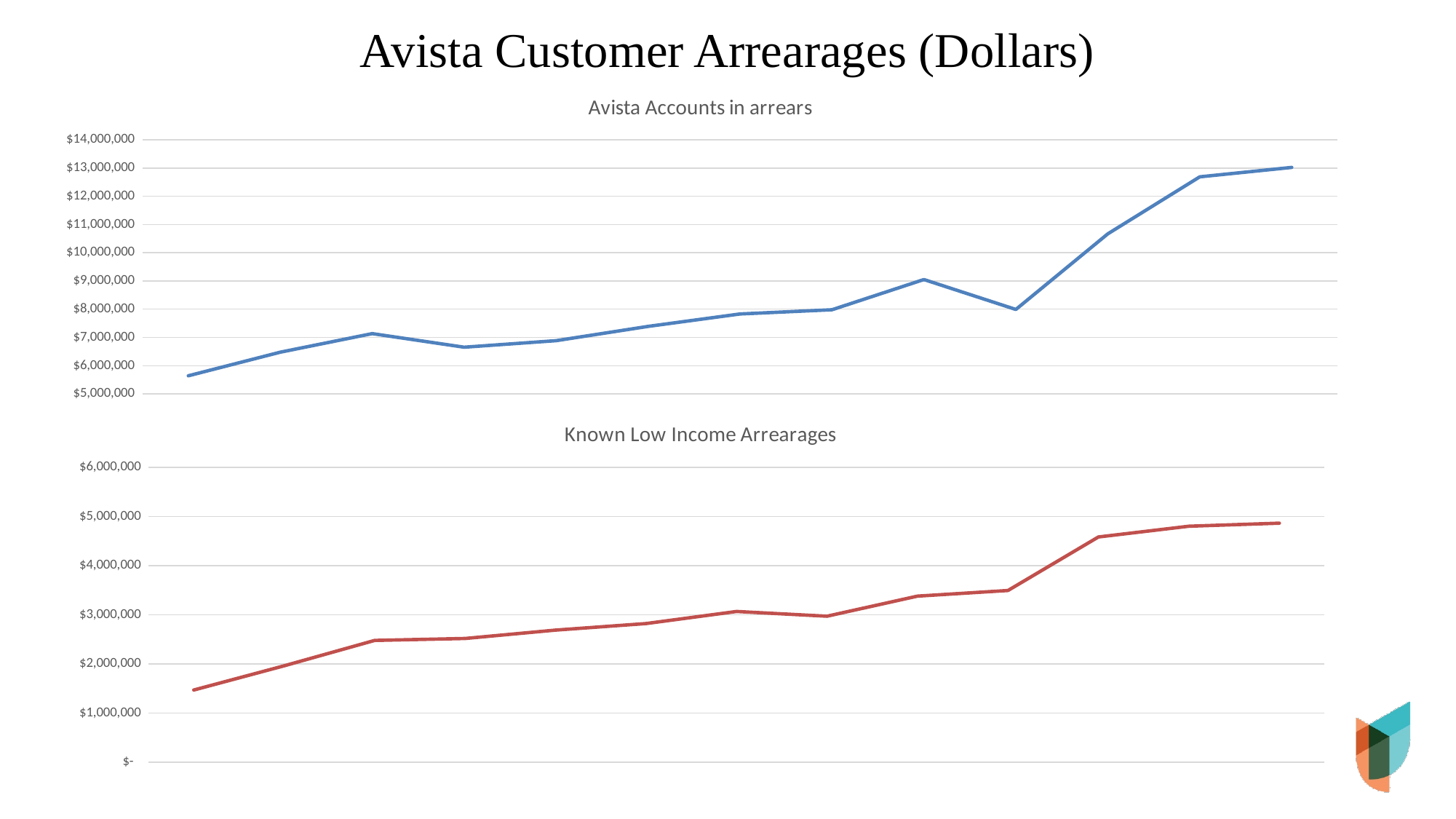
In the "Avista Accounts in arrears" chart, is the highest value at the left end or the right end of the line? right end In the "Avista Accounts in arrears" chart, is the first point on the line greater or less than $5,000,000? greater In the "Known Low Income Arrearages" chart, do the values generally rise or fall from left to right? rise In the "Known Low Income Arrearages" chart, is the last point on the line greater or less than $4,000,000? greater In the "Known Low Income Arrearages" chart, is the first point on the line greater or less than $2,000,000? less What kind of chart is the "Avista Accounts in arrears" chart at the top of the slide? line chart In the "Avista Accounts in arrears" chart, do the values generally rise or fall from left to right? rise What is the main title of the slide? Avista Customer Arrearages (Dollars) What colour is the line in the "Known Low Income Arrearages" chart? red What kind of chart is the "Known Low Income Arrearages" chart at the bottom of the slide? line chart